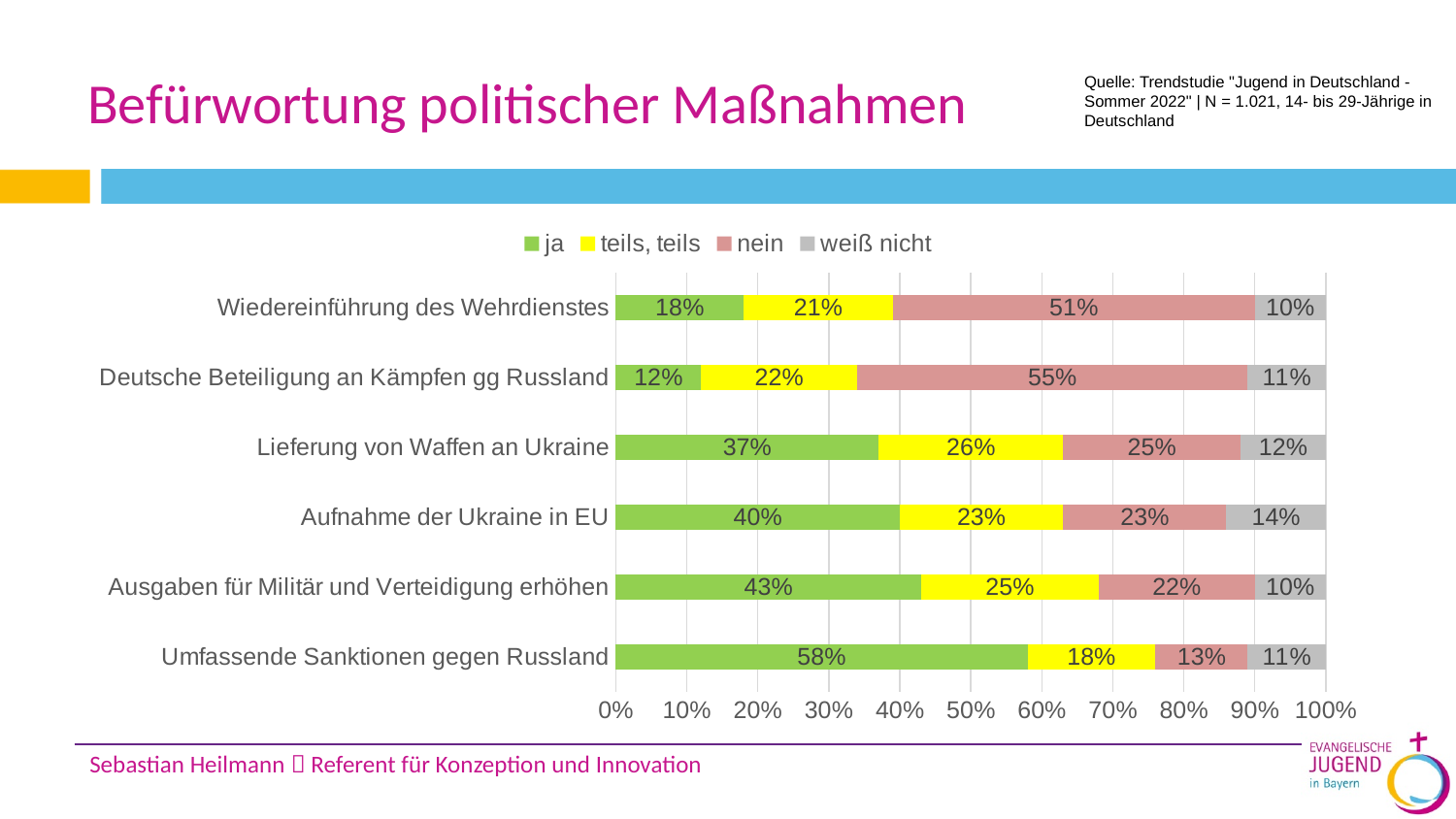
What is the title of the chart on the slide? Befürwortung politischer Maßnahmen Which is larger: the "ja" value for "Ausgaben für Militär und Verteidigung erhöhen" or the "ja" value for "Aufnahme der Ukraine in EU"? Ausgaben für Militär und Verteidigung erhöhen What is the "teils, teils" value for "Lieferung von Waffen an Ukraine"? 26% What is the "nein" value for "Deutsche Beteiligung an Kämpfen gg Russland"? 55% How many series does the legend list? 4 What is the "weiß nicht" value for "Aufnahme der Ukraine in EU"? 14% Which category has the lowest "ja" value? Deutsche Beteiligung an Kämpfen gg Russland What is the "ja" value for "Umfassende Sanktionen gegen Russland"? 58% How many categories (political measures) are shown in the chart? 6 What is the difference between the "nein" values for "Wiedereinführung des Wehrdienstes" and "Lieferung von Waffen an Ukraine"? 26% What kind of chart is shown on the slide? Stacked bar chart Which category has the highest "ja" value? Umfassende Sanktionen gegen Russland